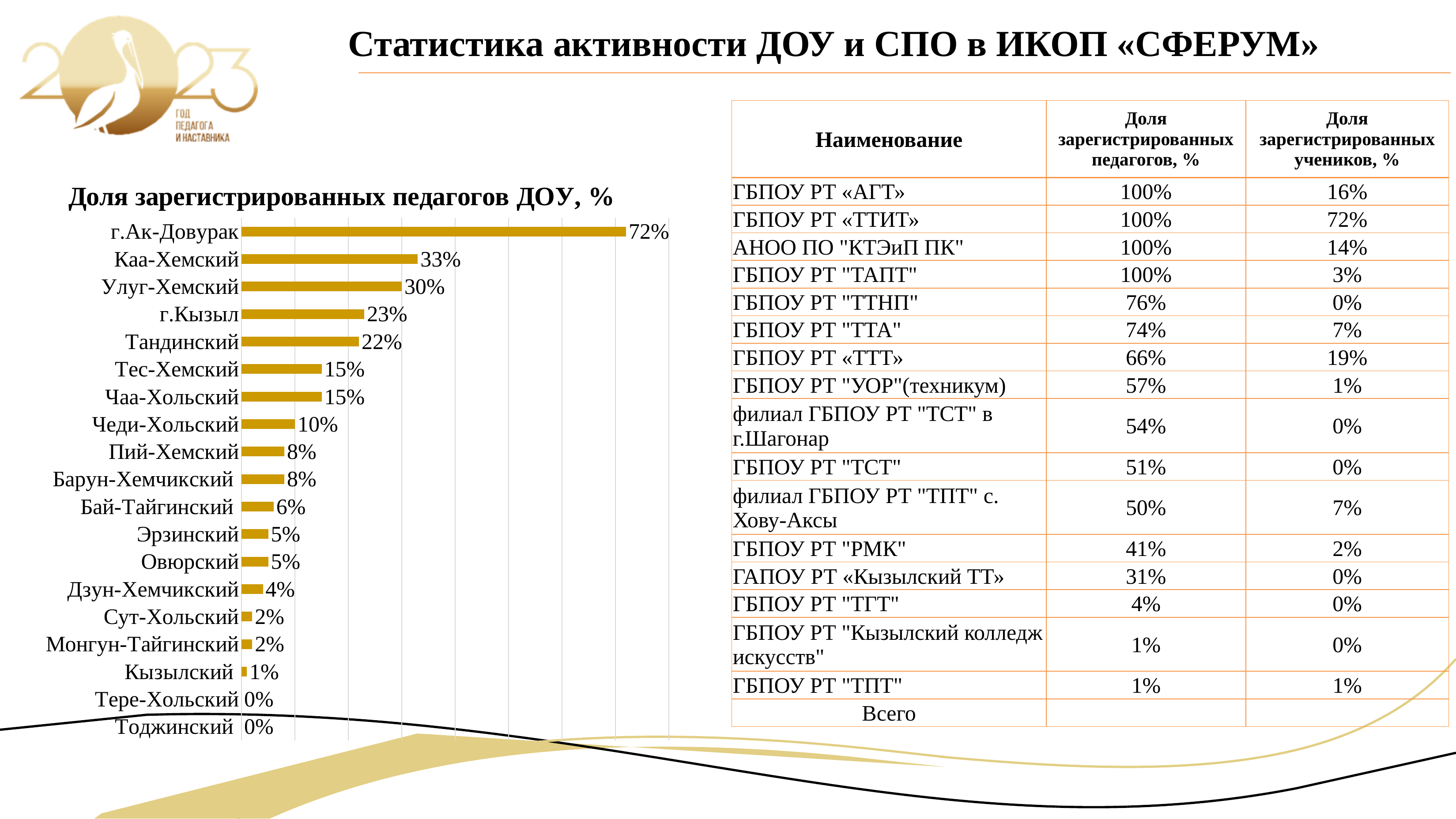
What is the difference between the values for г.Ак-Довурак and Каа-Хемский? 39% What type of chart is shown on the slide? bar chart Which is larger in the chart, the value for Улуг-Хемский or the value for Тандинский? Улуг-Хемский How many categories are shown in the chart? 19 What is the value for г.Кызыл in the chart? 23% What is the value for Каа-Хемский in the chart? 33% What is the title of the chart on the slide? Доля зарегистрированных педагогов ДОУ, % What is the difference between the values for Тандинский and Тес-Хемский? 7% What is the value for Чеди-Хольский in the chart? 10% How many categories in the chart have a value of 0%? 2 What is the value for г.Ак-Довурак in the chart? 72% Which category has the highest value in the chart? г.Ак-Довурак